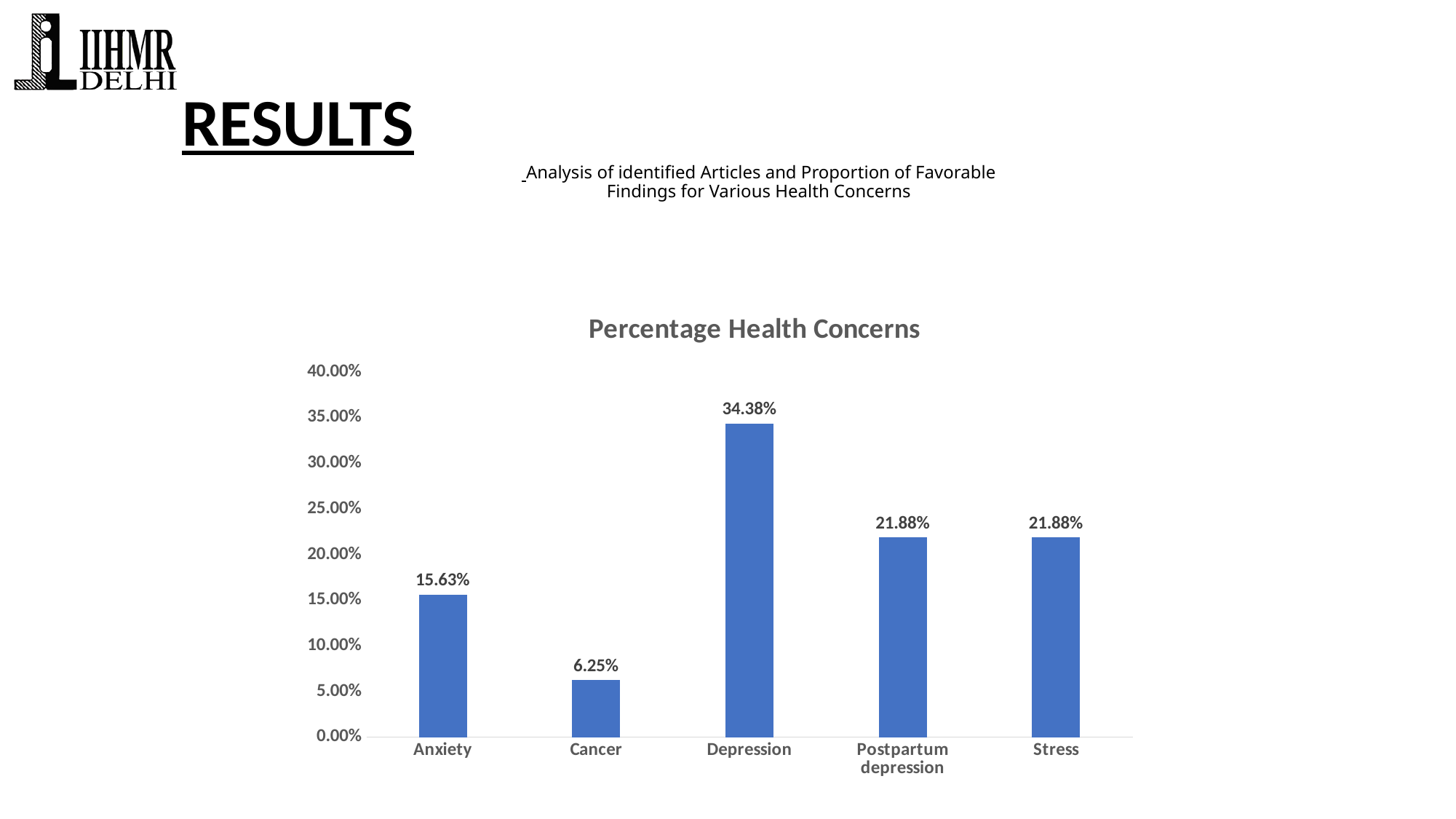
Which health concern has the lowest percentage in the chart? Cancer Which is larger, the value for Anxiety or the value for Stress? Stress Is the value for Depression greater or less than 30.00%? greater What is the value for Postpartum depression in the Percentage Health Concerns chart? 21.88% How many health concern categories are shown in the chart? 5 What is the value for Anxiety in the Percentage Health Concerns chart? 15.63% Which health concern has the highest percentage in the chart? Depression What kind of chart is used to show the Percentage Health Concerns? Bar chart What is the difference between the values for Stress and Cancer? 15.63% What is the value for Cancer in the Percentage Health Concerns chart? 6.25% What is the difference between the values for Depression and Anxiety? 18.75% What is the value for Depression in the Percentage Health Concerns chart? 34.38%